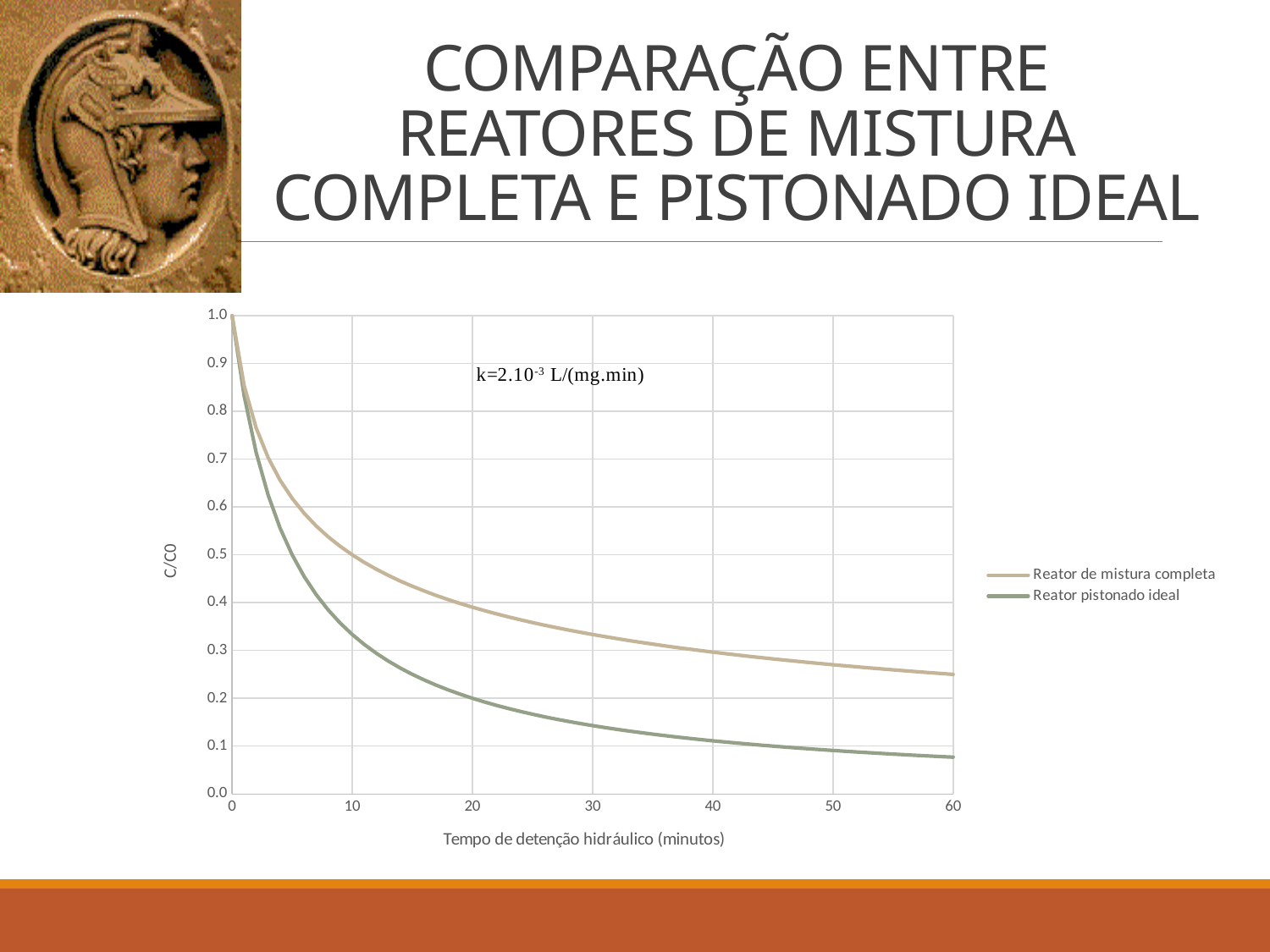
What is the title of the x axis of the chart? Tempo de detenção hidráulico (minutos) What is the C/C0 value of both series at a detention time of 0 minutes? 1.0 Is the C/C0 value for Reator pistonado ideal at 40 minutes greater or less than 0.2? less Is the C/C0 value for Reator pistonado ideal at 60 minutes greater or less than 0.1? less What value of k is annotated on the chart? k=2.10⁻³ L/(mg.min) Do the values of the Reator pistonado ideal series rise or fall as the hydraulic detention time increases? fall Is the C/C0 value for Reator de mistura completa at 20 minutes greater or less than 0.3? greater What kind of chart is shown on the slide? line chart Do the values of the Reator de mistura completa series rise or fall along the x axis? fall At a detention time of 30 minutes, which series has the larger C/C0 value, Reator de mistura completa or Reator pistonado ideal? Reator de mistura completa How many series does the legend list? 2